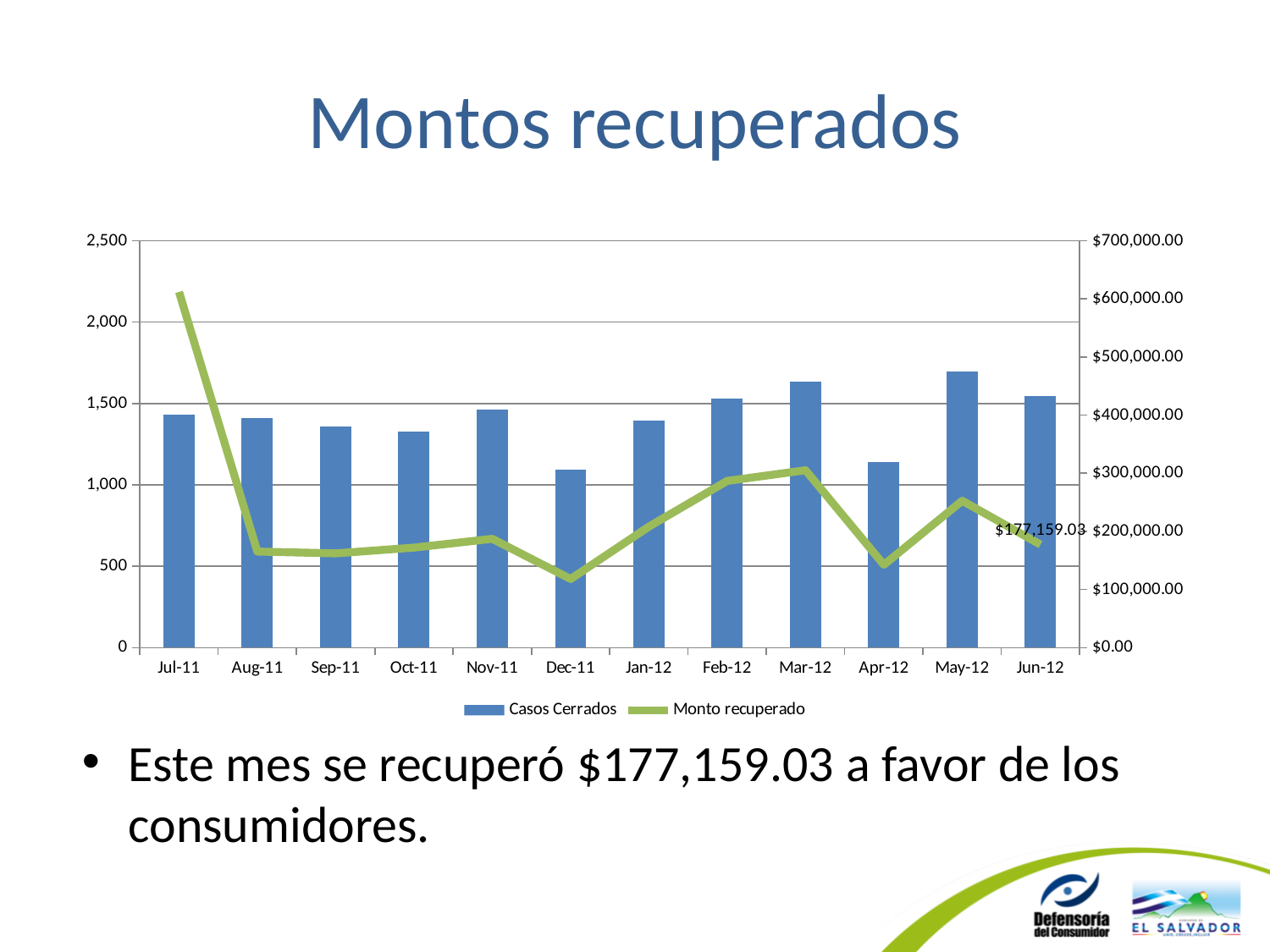
Is the Monto recuperado value for Jul-11 greater or less than $500,000.00? greater Does the Monto recuperado line rise or fall from Jul-11 to Aug-11? Fall How many series does the chart legend list? 2 How many months are shown on the x axis of the chart? 12 Which series is plotted as a line in the chart? Monto recuperado Is the Monto recuperado value for Dec-11 greater or less than $200,000.00? less Which month has the highest Casos Cerrados bar? May-12 Which has more Casos Cerrados, Mar-12 or Apr-12? Mar-12 Which month has the highest Monto recuperado value? Jul-11 What kind of chart is shown on the slide? Combined bar and line chart Is the Casos Cerrados value for May-12 greater or less than 1,500? greater What is the Monto recuperado value shown for Jun-12? $177,159.03